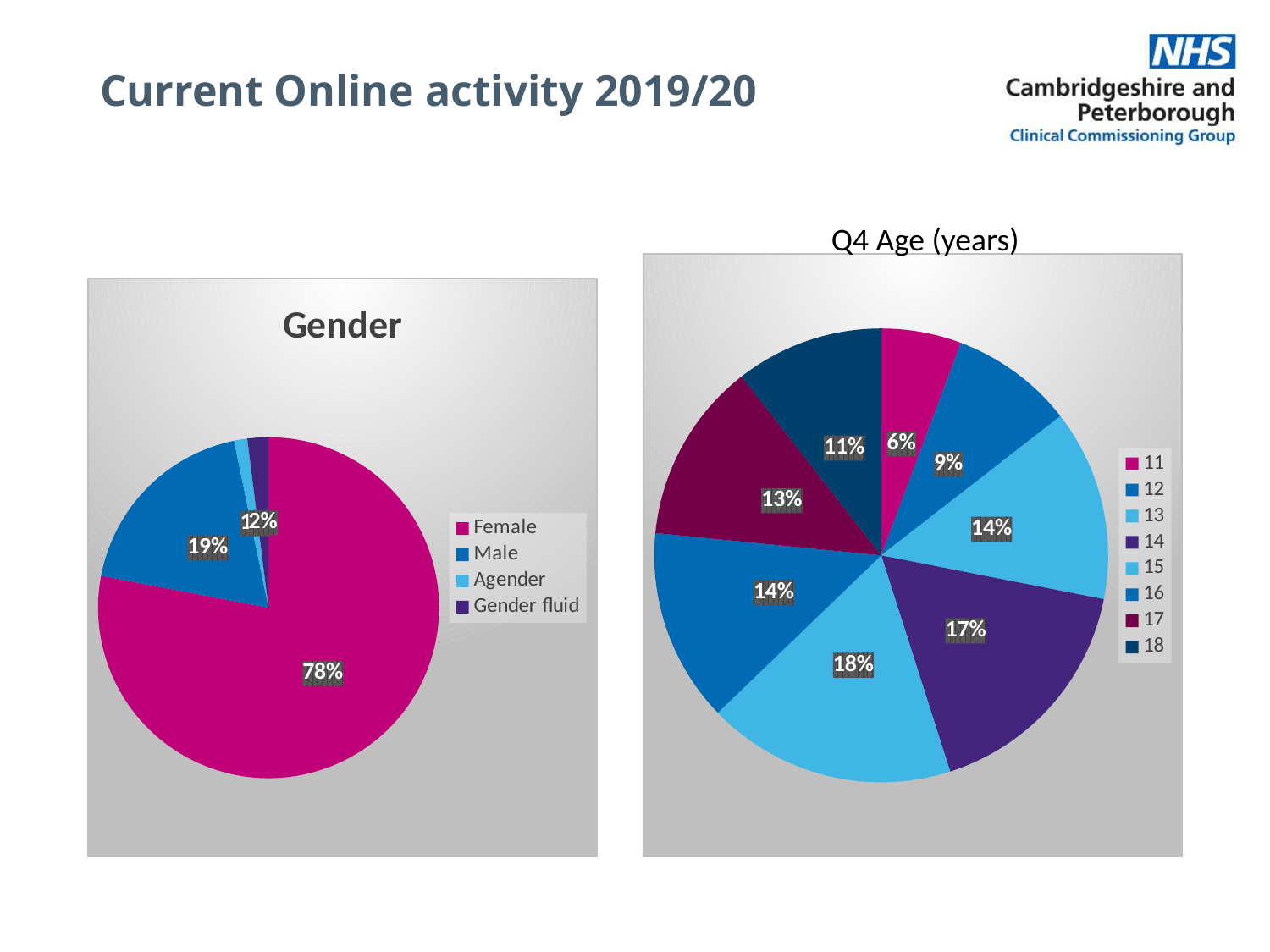
In the Q4 Age (years) pie chart, which age has the smallest share? 11 In the Gender pie chart, how many categories does the legend list? 4 In the Gender pie chart, which category has the largest slice? Female In the Q4 Age (years) pie chart, which age has the largest share? 15 In the Q4 Age (years) pie chart, how many age categories does the legend list? 8 In the Gender pie chart, what share is Female? 78% In the Q4 Age (years) pie chart, what share is age 15? 18% What kind of chart is the Q4 Age (years) chart? Pie chart In the Gender pie chart, what share is Male? 19% In the Gender pie chart, what is the difference between the Female and Male shares? 59% In the Q4 Age (years) pie chart, which is larger, the share for age 14 or age 17? 14 In the Q4 Age (years) pie chart, what share is age 11? 6%